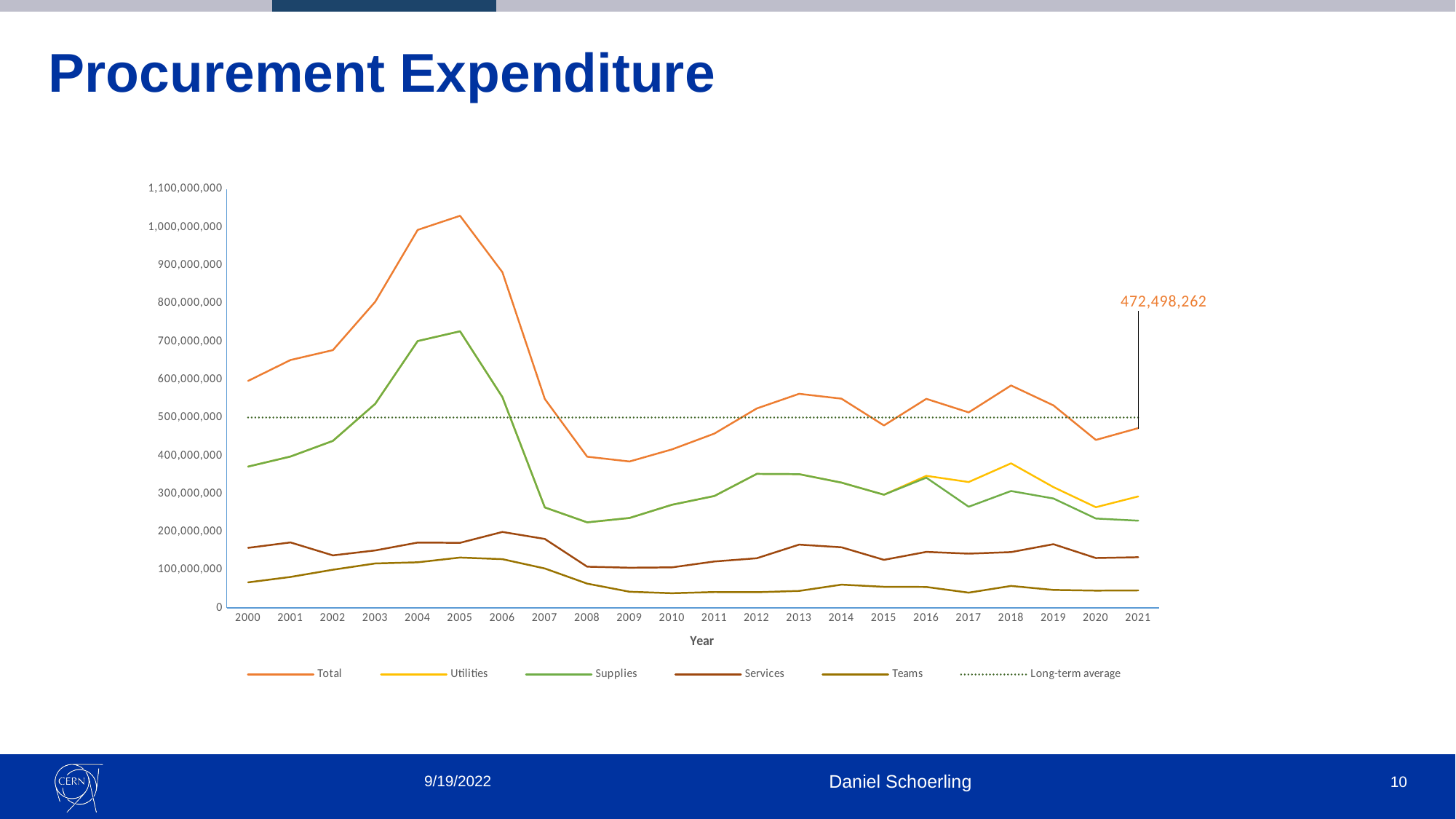
In which year does the Total series reach its highest value? 2005 What kind of chart is shown on the slide? line chart Does the Total series rise or fall between 2005 and 2008? fall What is the value of the Total series in 2021? 472,498,262 Is the value of the Total series in 2004 greater or less than 900,000,000? greater In 2018, which is larger: Utilities or Supplies? Utilities Which series is drawn as a dotted line? Long-term average Is the value of the Teams series in 2010 greater or less than 100,000,000? less Which is larger: the Total value in 2004 or the Total value in 2012? 2004 Is the value of the Total series in 2020 greater or less than 500,000,000? less How many years are plotted along the x axis? 22 How many series does the legend list? 6